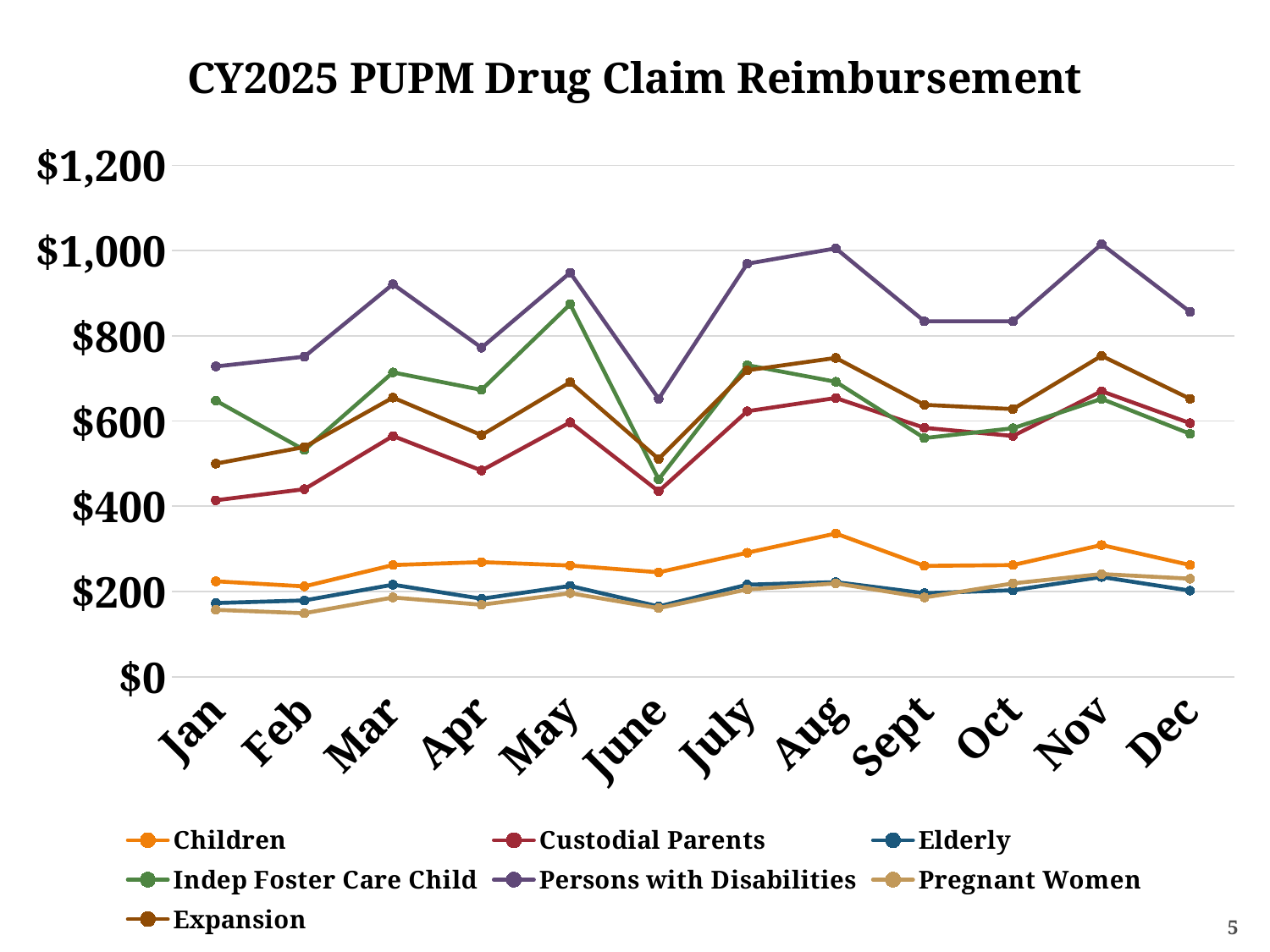
Is the value for Expansion in Jan greater or less than $600? less How many series does the legend list? 7 In which month is the Persons with Disabilities value lowest? June Is the value for Children in Aug greater or less than $400? less What kind of chart is shown on the slide? line chart Which series has the highest values across the year? Persons with Disabilities In Jan, which is larger: Indep Foster Care Child or Expansion? Indep Foster Care Child How many months are plotted along the x axis? 12 Which series has the lowest value in Feb? Pregnant Women Is the value for Persons with Disabilities in June greater or less than $800? less In which month is the Children value highest? Aug Does the Persons with Disabilities line rise or fall from June to Aug? rise